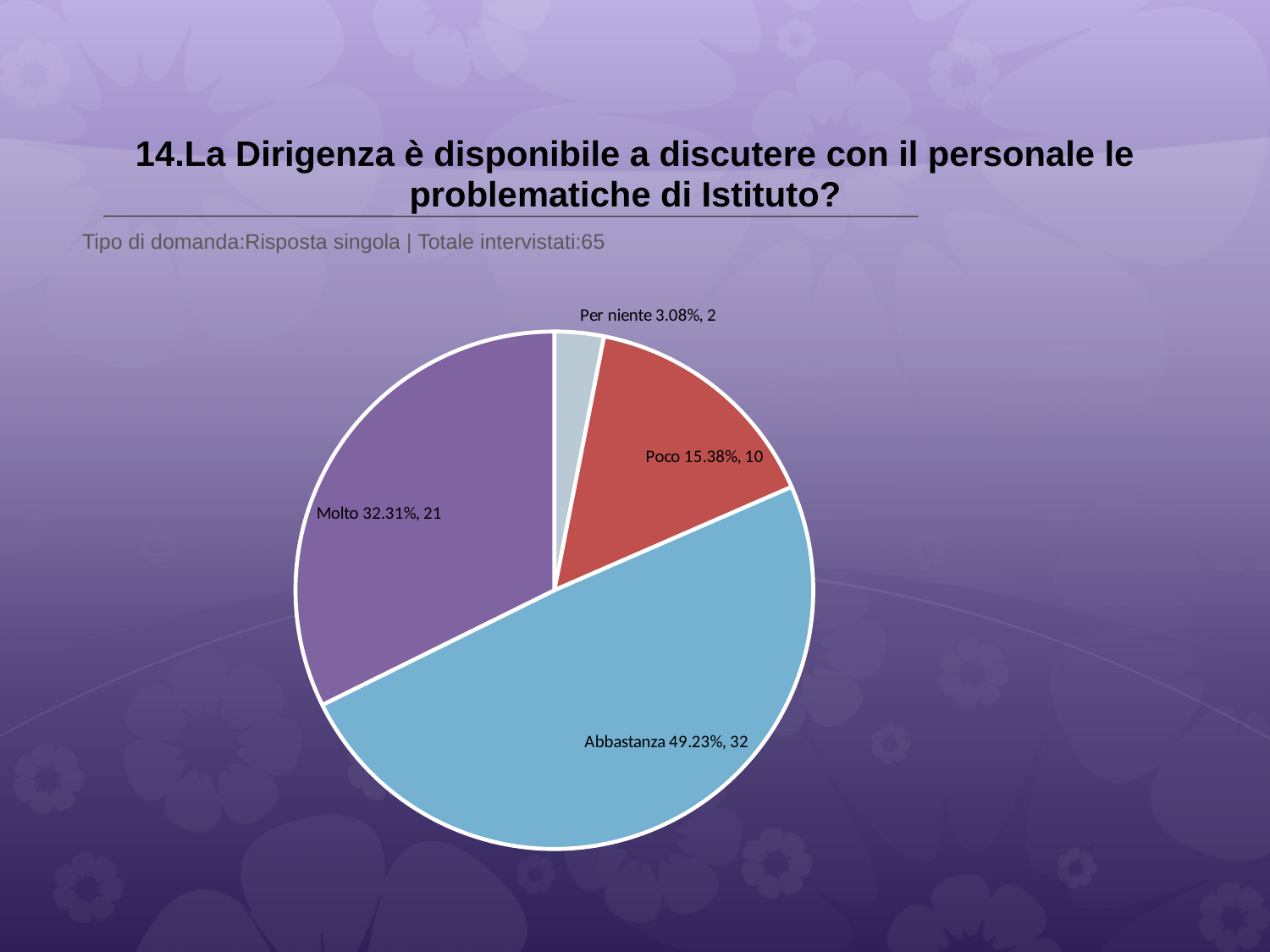
How many respondents answered 'Molto'? 21 What is the difference in number of respondents between 'Abbastanza' and 'Molto'? 11 What percentage share does the 'Abbastanza' slice represent? 49.23% Which response category has the smallest slice? Per niente What kind of chart is shown on the slide? pie chart Which has more respondents, 'Poco' or 'Molto'? Molto What percentage share does the 'Per niente' slice represent? 3.08% How many respondents answered 'Poco'? 10 Which response category has the largest slice? Abbastanza How many slices does the pie chart have? 4 What colour is the 'Abbastanza' slice? blue What is the total number of respondents (Totale intervistati) stated on the slide? 65